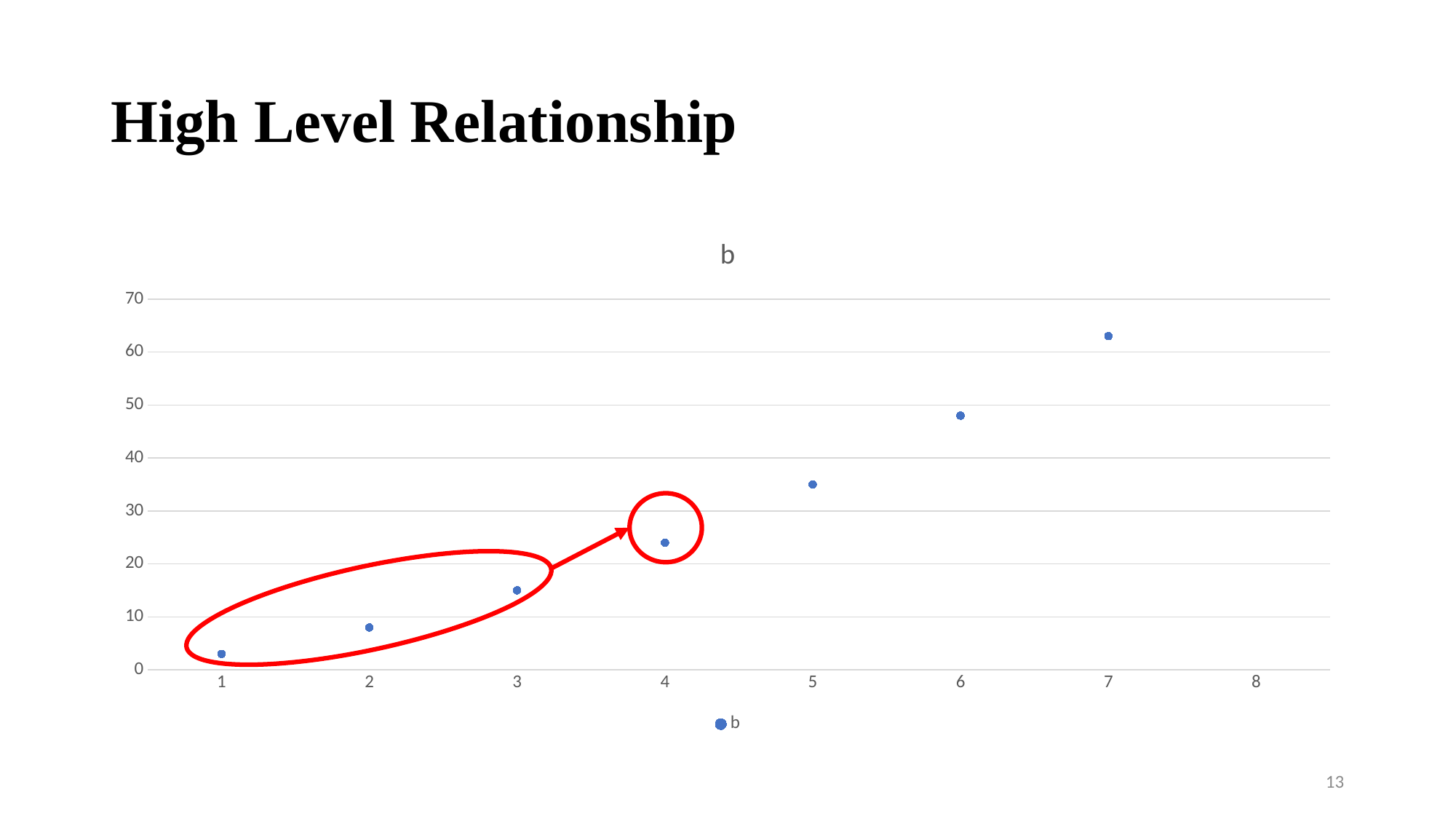
At which x value is the plotted value highest? 7 How many data points are plotted in the chart? 7 How many series does the legend list? 1 Is the value at x = 5 greater or less than 30? greater What kind of chart is shown on the slide? scatter chart At which x value is the plotted value lowest? 1 What is the title of the chart? b Is the value at x = 1 greater or less than 10? less Which has the larger value, the point at x = 6 or the point at x = 3? x = 6 Is the value at x = 7 greater or less than 60? greater Do the values rise or fall as x increases from 1 to 7? rise